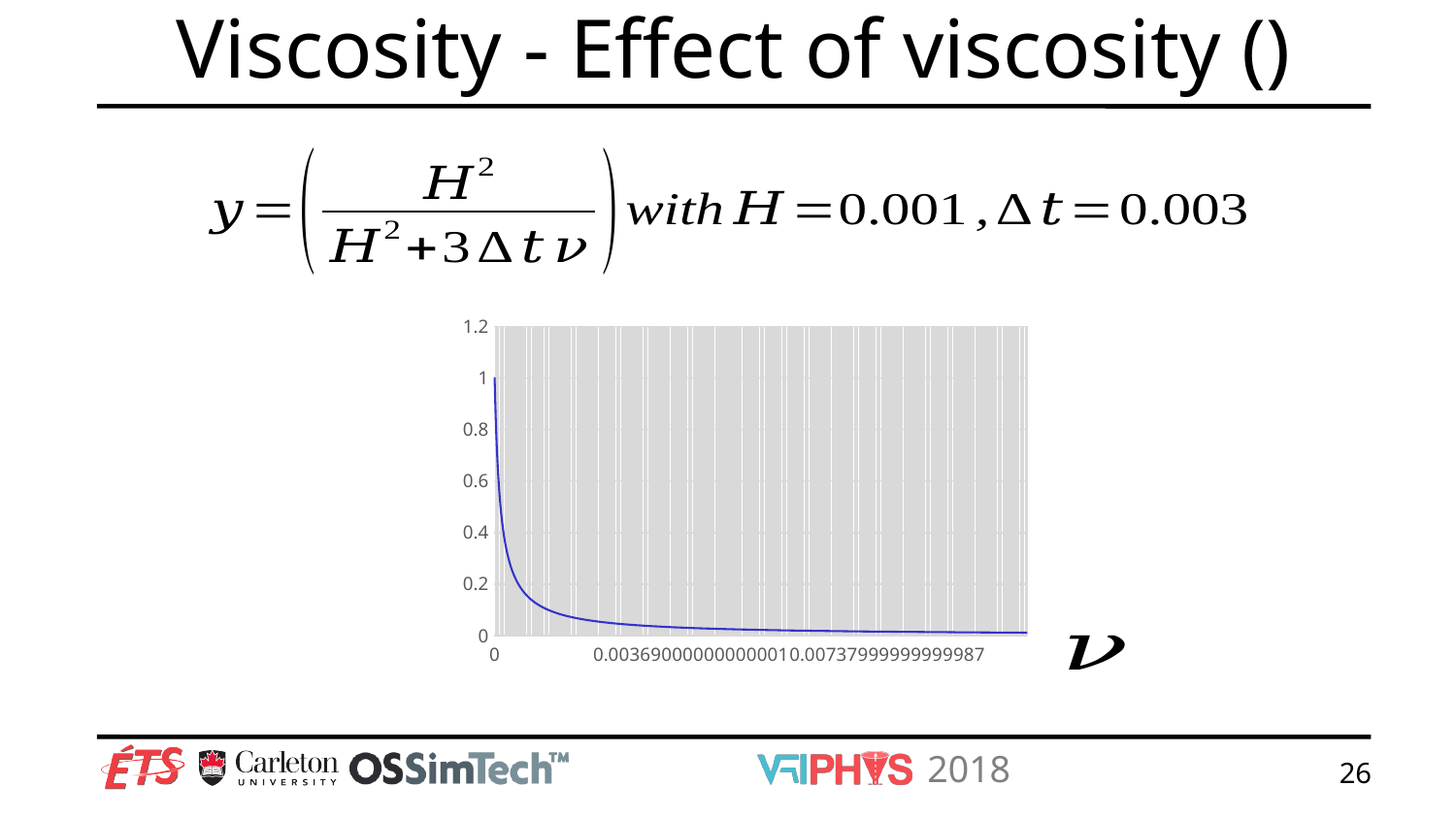
What is the highest tick value shown on the y axis? 1.2 Is the value of the curve at ν = 0.00369000000000001 greater or less than 0.2? less What symbol labels the x axis of the chart? ν At which x-axis value does the curve reach its highest point? 0 As ν increases along the x axis, does the plotted value rise or fall? fall Is the value of the curve at ν = 0.00737999999999987 greater or less than 0.2? less What is the value of the curve at ν = 0? 1 How many lines are plotted on the chart? 1 What kind of chart is shown on the slide? line chart